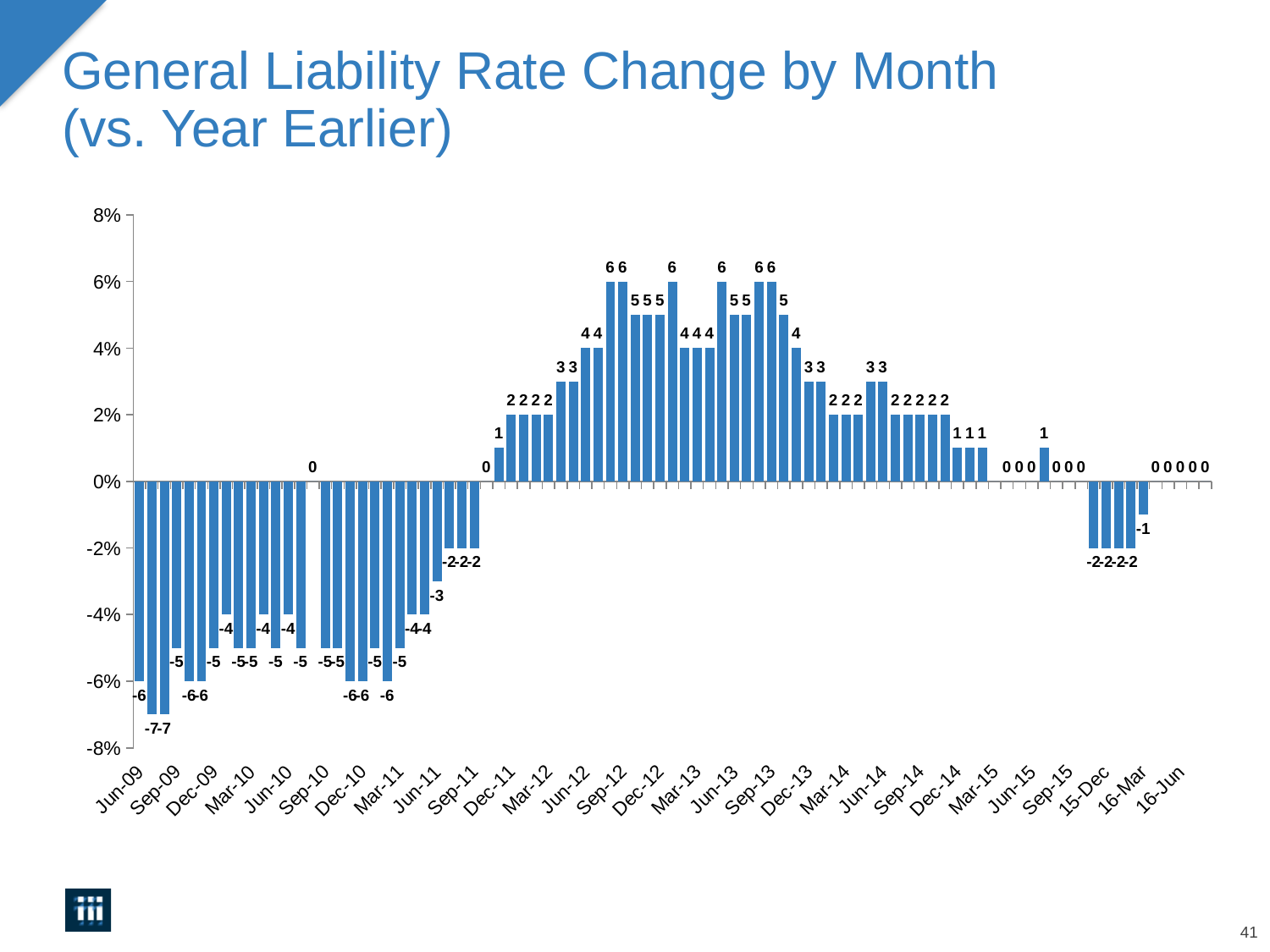
What is the value labeled on the first bar (Jun-09)? -6 Do the values generally rise or fall from Jun-09 to Sep-12? rise What is the title of the chart? General Liability Rate Change by Month (vs. Year Earlier) What is the highest value shown on the vertical axis? 8% What is the highest value labeled on any bar in the chart? 6 Do the values generally rise or fall from Sep-13 to Jun-15? fall Which is larger, the value for Jun-09 or the value for 16-Jun? 16-Jun What kind of chart is shown on the slide? bar chart What is the value labeled on the last bar (16-Jun)? 0 What is the lowest value labeled on any bar in the chart? -7 What is the difference between the highest labeled value (6) and the lowest labeled value (-7)? 13 How many bars are labeled -7? 2